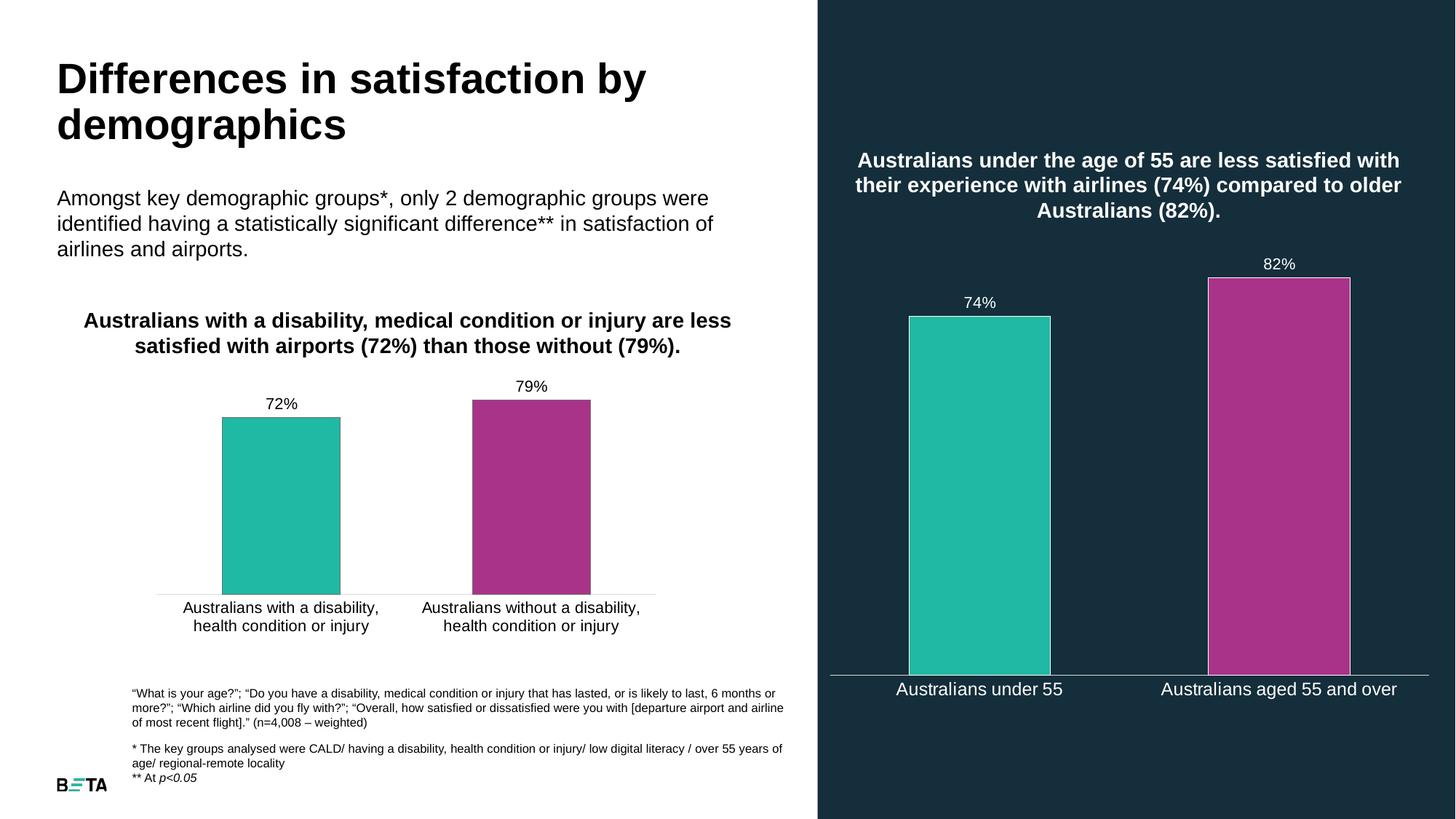
In the left chart on airport satisfaction, what is the difference between the two bars? 7 percentage points In the left chart on airport satisfaction, what is the value for Australians without a disability, health condition or injury? 79% In the right chart on airline satisfaction, what is the value for Australians aged 55 and over? 82% In the right chart on airline satisfaction, which category has the lower value? Australians under 55 Is the value for Australians under 55 in the right chart larger or smaller than the value for Australians with a disability, health condition or injury in the left chart? Larger In the right chart on airline satisfaction, what is the difference between the two bars? 8 percentage points In the right chart on airline satisfaction, what colour is the bar for Australians aged 55 and over? Magenta/purple In the left chart on airport satisfaction, what is the value for Australians with a disability, health condition or injury? 72% In the right chart on airline satisfaction, what is the value for Australians under 55? 74% In the left chart on airport satisfaction, which category has the higher value? Australians without a disability, health condition or injury In the left chart on airport satisfaction, how many bars are plotted? 2 What kind of chart is the right chart on airline satisfaction? Bar chart